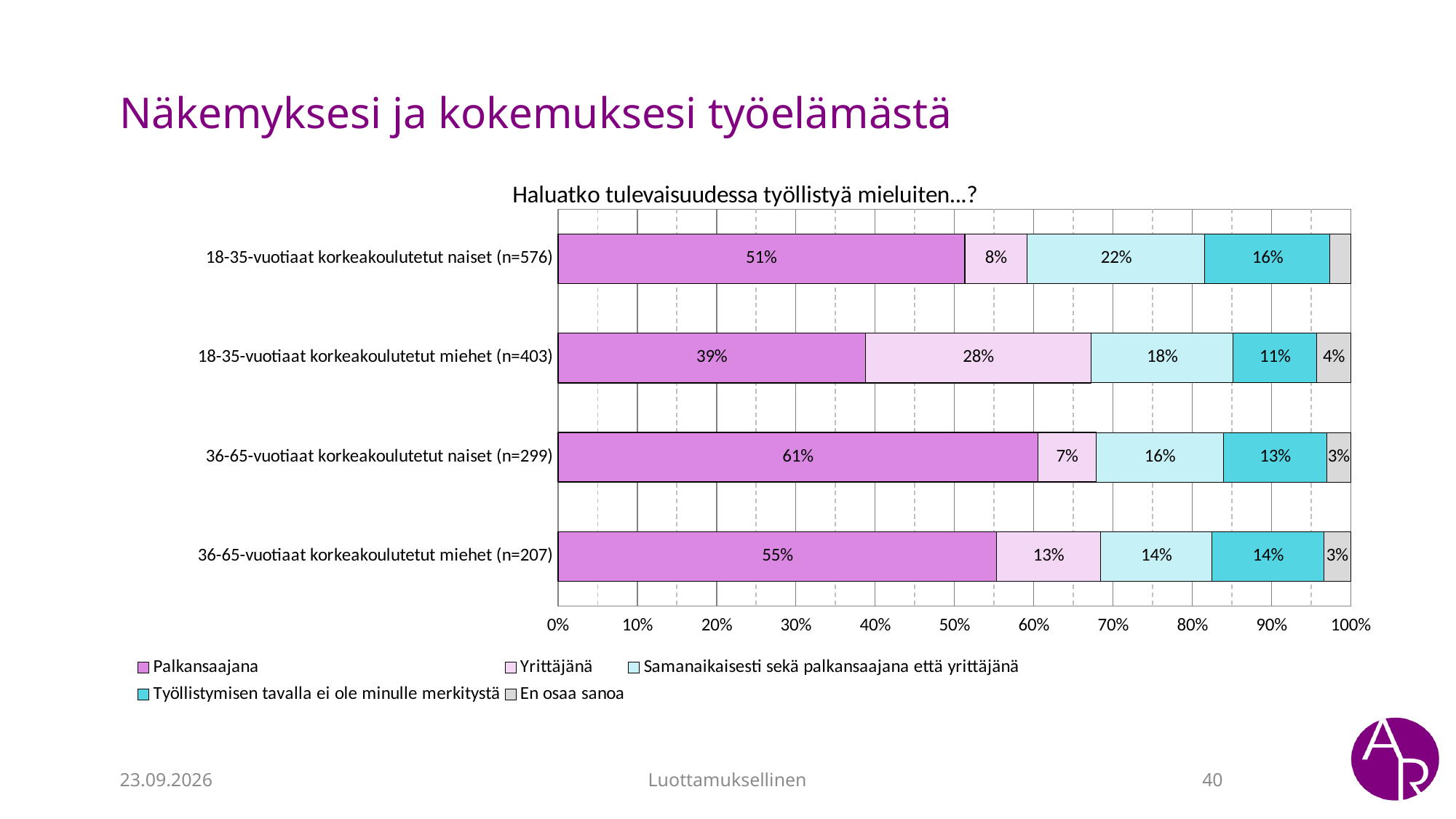
What kind of chart is shown on the slide? stacked bar chart What is the difference between the Yrittäjänä values for 18-35-vuotiaat korkeakoulutetut miehet (n=403) and 18-35-vuotiaat korkeakoulutetut naiset (n=576)? 20% How many series does the legend list? 5 What is the En osaa sanoa value for 18-35-vuotiaat korkeakoulutetut miehet (n=403)? 4% What is the Palkansaajana value for 36-65-vuotiaat korkeakoulutetut naiset (n=299)? 61% Which group has the highest Palkansaajana value? 36-65-vuotiaat korkeakoulutetut naiset (n=299) What is the title of the chart? Haluatko tulevaisuudessa työllistyä mieluiten…? Which group has the lowest Palkansaajana value? 18-35-vuotiaat korkeakoulutetut miehet (n=403) How many categories (respondent groups) are shown on the chart? 4 What is the Yrittäjänä value for 18-35-vuotiaat korkeakoulutetut miehet (n=403)? 28% What is the Samanaikaisesti sekä palkansaajana että yrittäjänä value for 18-35-vuotiaat korkeakoulutetut naiset (n=576)? 22% Which is larger: the Työllistymisen tavalla ei ole minulle merkitystä value for 18-35-vuotiaat korkeakoulutetut naiset (n=576) or for 18-35-vuotiaat korkeakoulutetut miehet (n=403)? 18-35-vuotiaat korkeakoulutetut naiset (n=576)